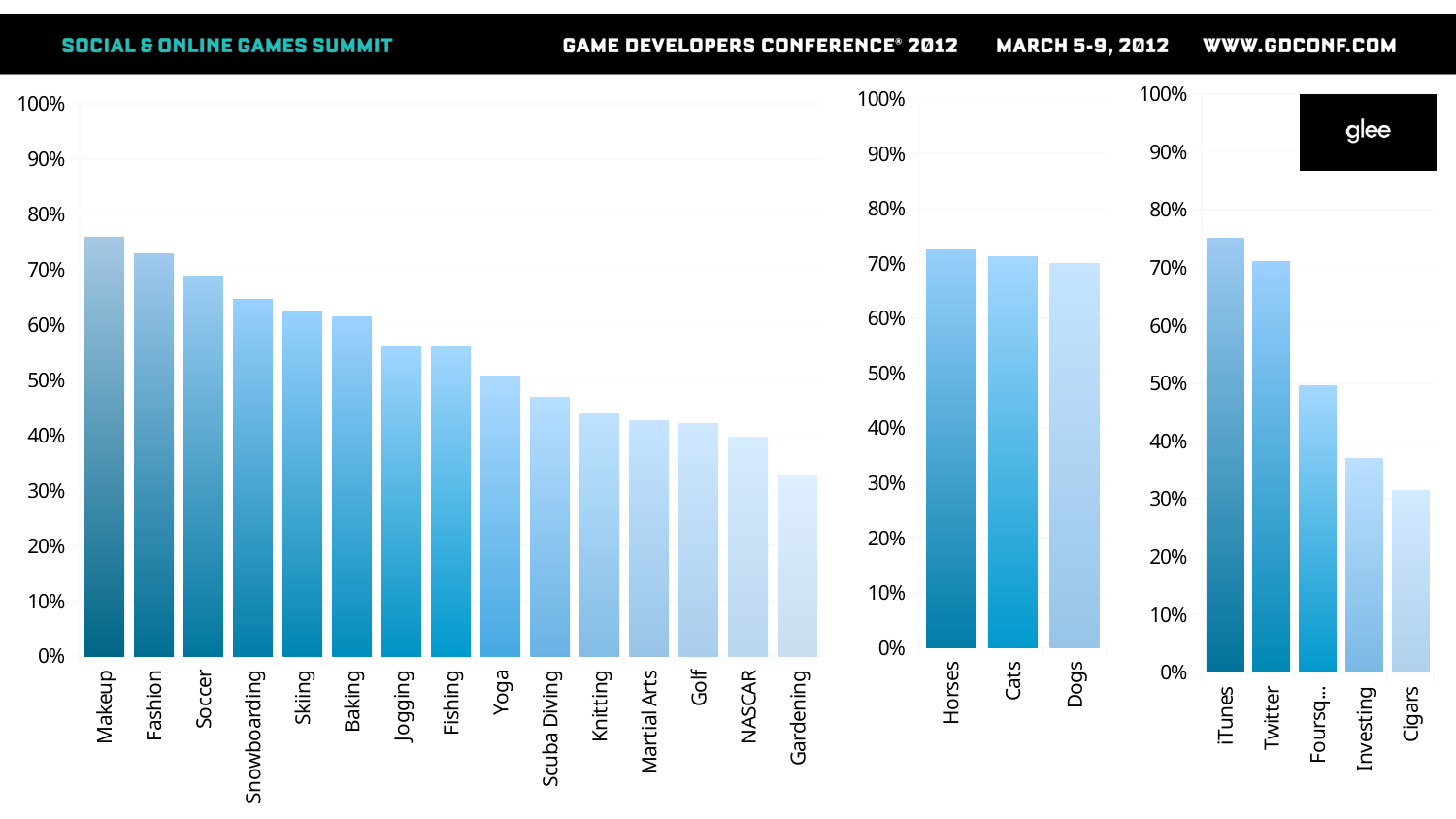
On the left chart, which has the larger value, Soccer or Yoga? Soccer On the left chart, is the value for Gardening greater or less than 40%? less On the right chart, is the value for Investing greater or less than 40%? less On the left chart, which category has the highest value? Makeup On the left chart, is the value for Makeup greater or less than 70%? greater What kind of chart is the middle chart? bar chart How many categories are shown on the left chart? 15 On the right chart, which category has the highest value? iTunes How many categories are shown on the middle chart? 3 On the left chart, do the values rise or fall from left to right along the x axis? fall On the left chart, which category has the lowest value? Gardening